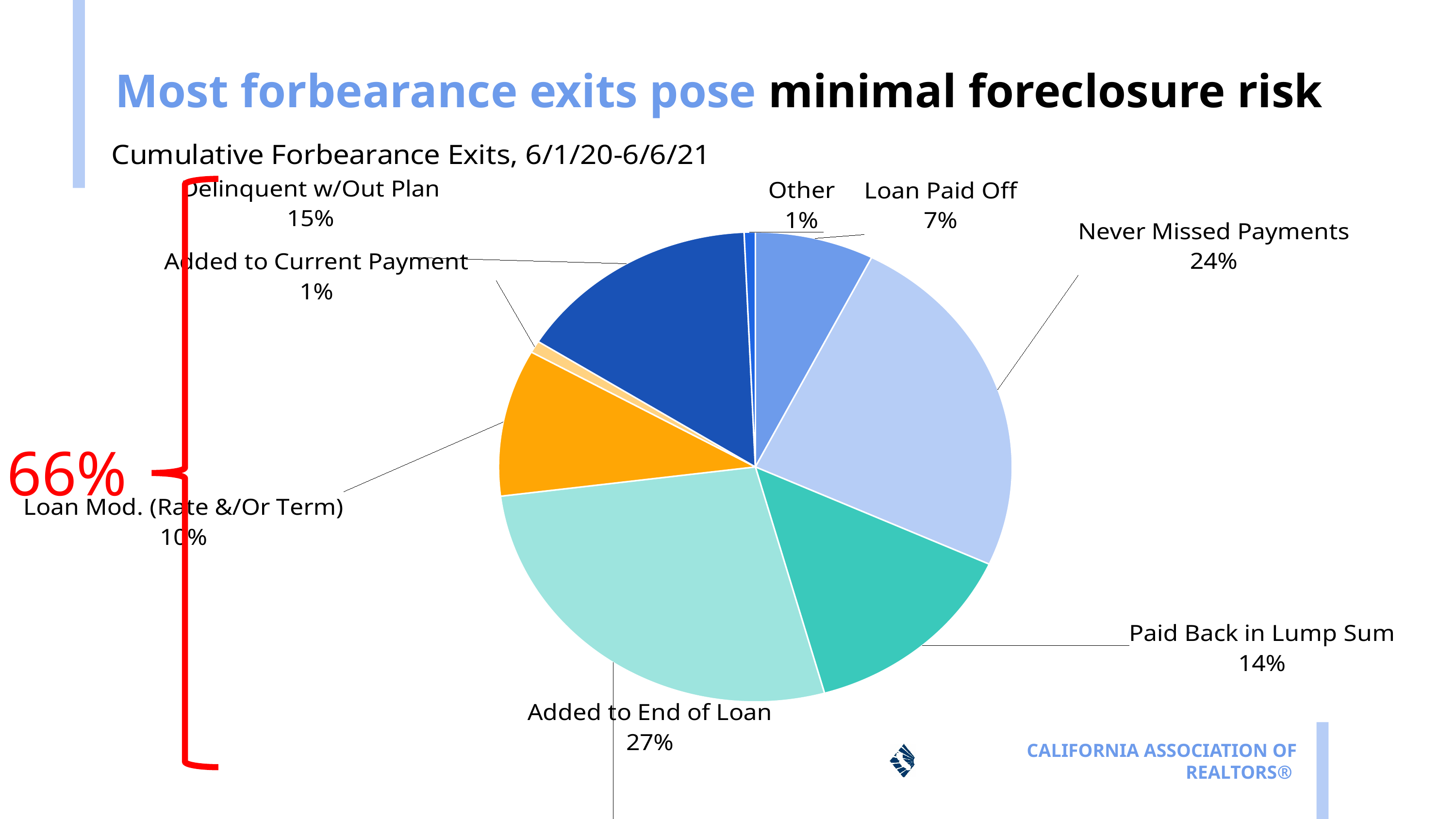
Which is larger: the share for Delinquent w/Out Plan or the share for Paid Back in Lump Sum? Delinquent w/Out Plan What is the difference in percentage points between Added to End of Loan and Never Missed Payments? 3 percentage points What share of cumulative forbearance exits was Added to End of Loan? 27% How many slices does the pie chart have? 8 What share of exits was Loan Mod. (Rate &/Or Term)? 10% What percentage is shown in red next to the bracket on the left of the chart? 66% What type of chart is shown on the slide? Pie chart What percentage of exits were Delinquent w/Out Plan? 15% What percentage of forbearance exits were Never Missed Payments? 24% Which category accounts for the largest share of forbearance exits? Added to End of Loan What share of exits was Paid Back in Lump Sum? 14% What is the title of the chart? Cumulative Forbearance Exits, 6/1/20-6/6/21